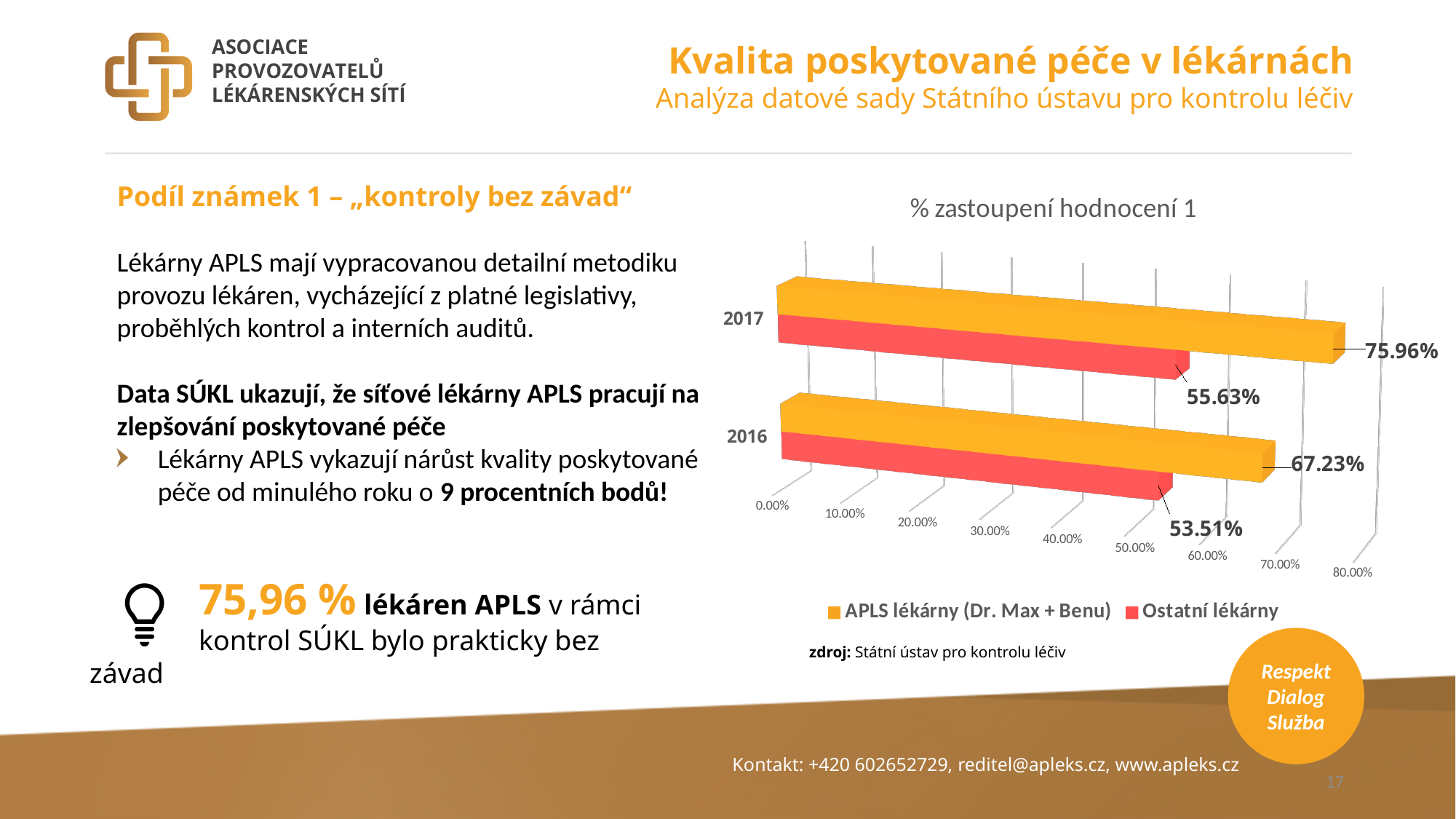
What is the title of the chart? % zastoupení hodnocení 1 How many series does the legend list? 2 Which series has the highest value in the chart? APLS lékárny (Dr. Max + Benu) What is the value for APLS lékárny (Dr. Max + Benu) in 2016? 67.23% Which is larger: Ostatní lékárny in 2017 or APLS lékárny (Dr. Max + Benu) in 2016? APLS lékárny (Dr. Max + Benu) in 2016 Which series has the lowest value in 2016? Ostatní lékárny What is the difference between APLS lékárny (Dr. Max + Benu) and Ostatní lékárny in 2017? 20.33% What is the value for Ostatní lékárny in 2016? 53.51% What is the value for APLS lékárny (Dr. Max + Benu) in 2017? 75.96% What kind of chart is shown on the slide? Bar chart What is the value for Ostatní lékárny in 2017? 55.63% By how much did the value for APLS lékárny (Dr. Max + Benu) change from 2016 to 2017? 8.73%